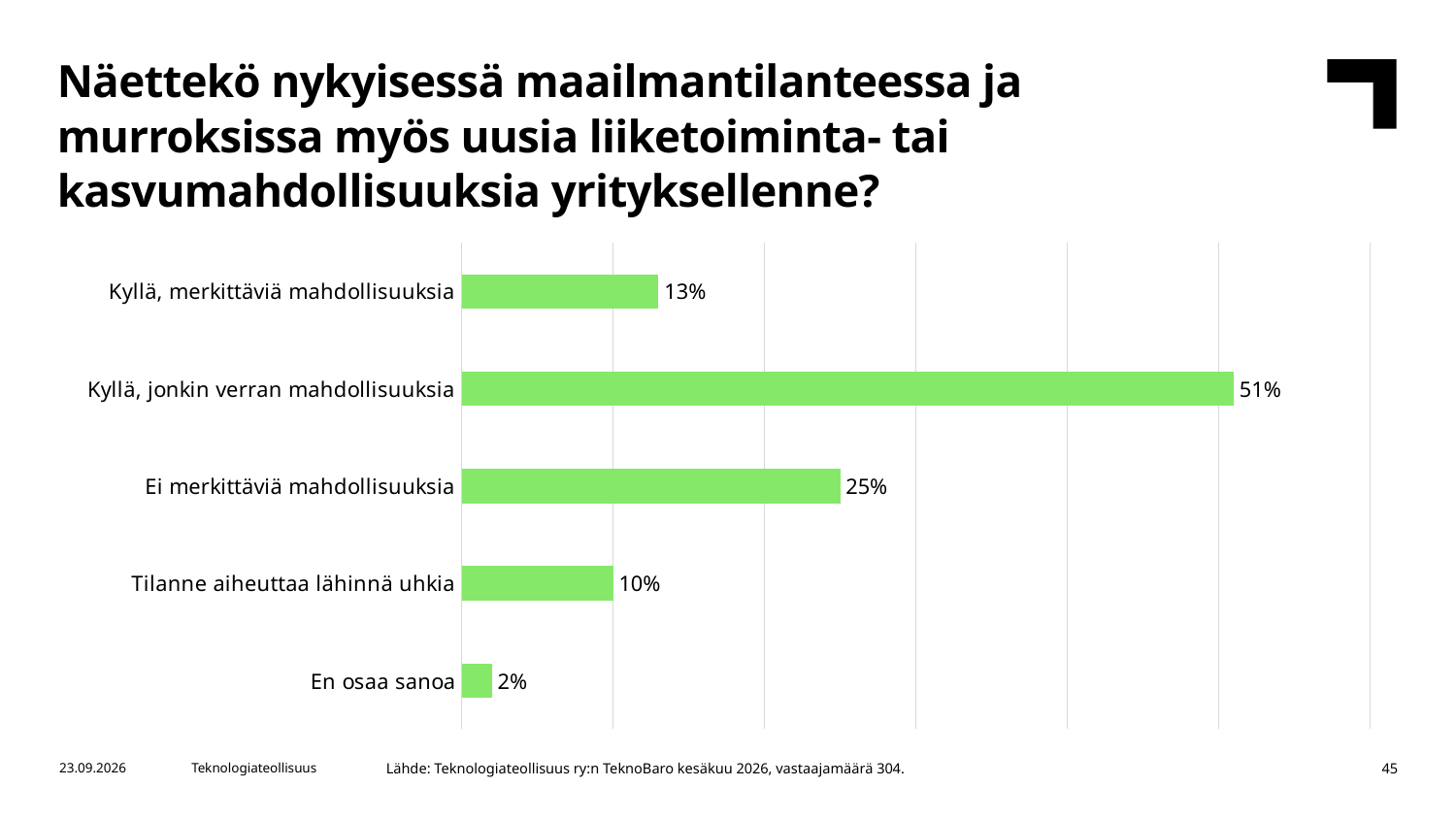
Which category has the lowest value? En osaa sanoa What is the value for "Kyllä, jonkin verran mahdollisuuksia"? 51% What is the value for "Ei merkittäviä mahdollisuuksia"? 25% Which category has the highest value? Kyllä, jonkin verran mahdollisuuksia Which is larger: "Kyllä, merkittäviä mahdollisuuksia" or "Tilanne aiheuttaa lähinnä uhkia"? Kyllä, merkittäviä mahdollisuuksia What is the difference between "Kyllä, jonkin verran mahdollisuuksia" and "Ei merkittäviä mahdollisuuksia"? 26% What is the value for "Tilanne aiheuttaa lähinnä uhkia"? 10% What is the difference between "Kyllä, merkittäviä mahdollisuuksia" and "En osaa sanoa"? 11% What colour are the bars in the chart? Green What is the value for "En osaa sanoa"? 2% What kind of chart is shown on the slide? Bar chart How many categories are shown in the chart? 5